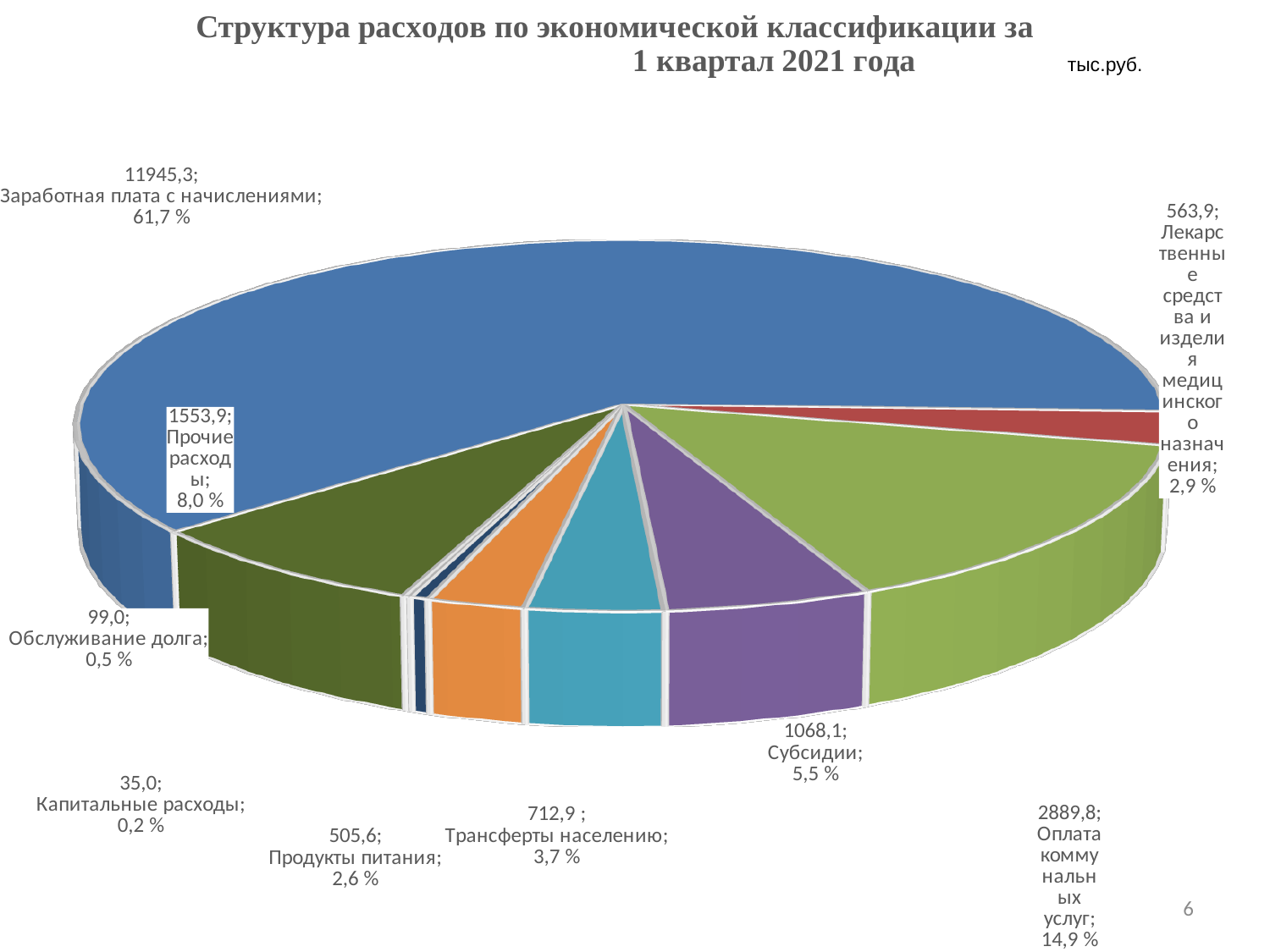
Which is larger: Трансферты населению or Продукты питания? Трансферты населению What type of chart is shown on the slide? Pie chart What is the value for Субсидии? 1068,1 What is the value for Заработная плата с начислениями? 11945,3 What percentage is shown for Прочие расходы? 8,0 % What share of the pie does Оплата коммунальных услуг represent? 14,9 % What unit of measurement is indicated next to the chart title? тыс.руб. What is the difference between the values for Оплата коммунальных услуг and Прочие расходы? 1335,9 How many categories are shown in the pie chart? 9 Which category has the largest slice of the pie? Заработная плата с начислениями Which category has the smallest slice of the pie? Капитальные расходы What is the value for Обслуживание долга? 99,0